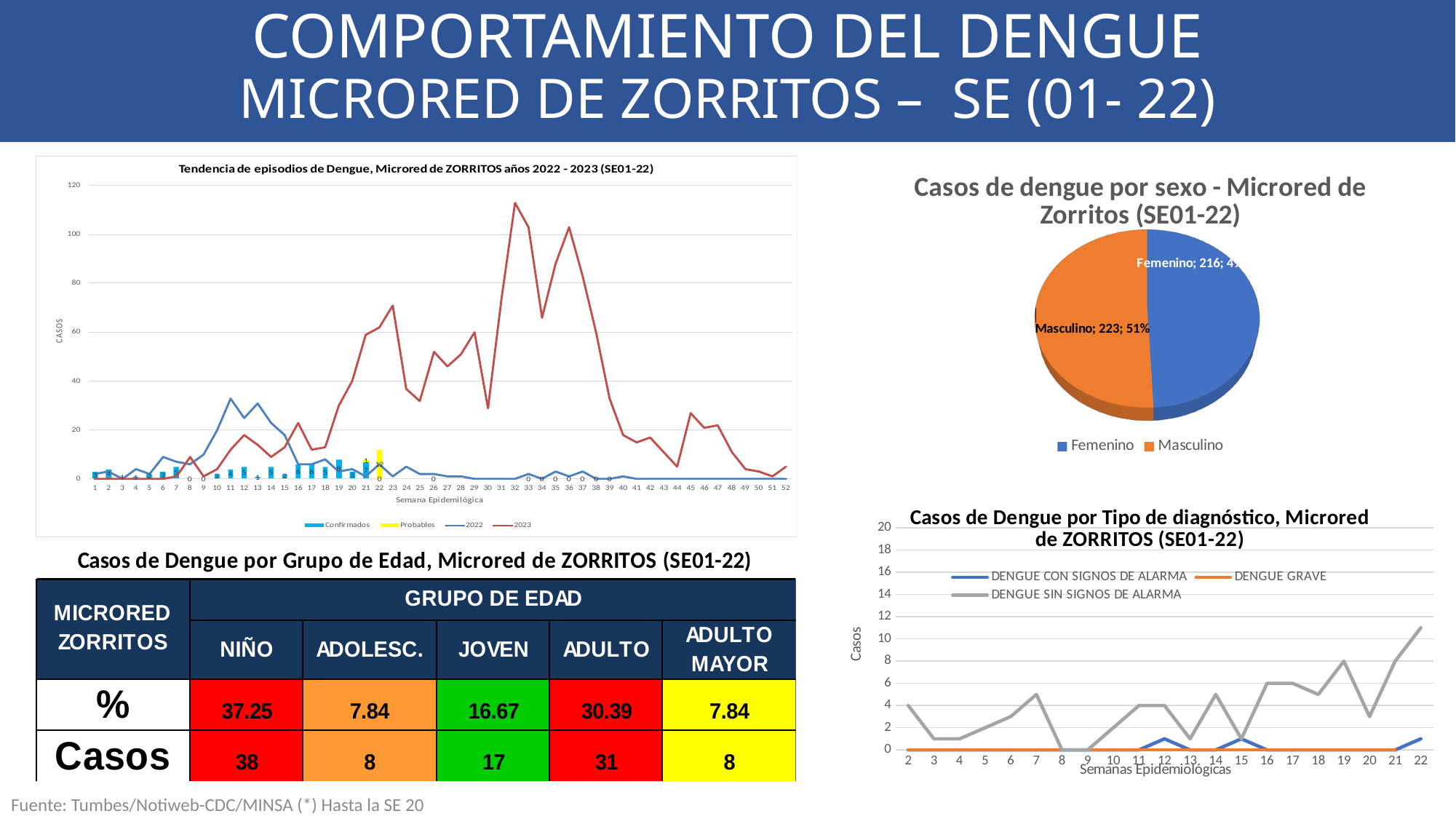
In the chart 'Tendencia de episodios de Dengue', is the 2023 value at week 32 greater or less than 100? greater In the pie chart 'Casos de dengue por sexo', how many cases are Femenino? 216 In the pie chart 'Casos de dengue por sexo', what share of cases is Masculino? 51% What kind of chart is 'Casos de dengue por sexo - Microred de Zorritos (SE01-22)'? pie chart In the chart 'Casos de Dengue por Tipo de diagnóstico', is the DENGUE SIN SIGNOS DE ALARMA value at week 22 greater or less than 8? greater In the chart 'Tendencia de episodios de Dengue', at which epidemiological week does the 2023 line reach its highest value? 32 How many series does the legend of the chart 'Tendencia de episodios de Dengue, Microred de ZORRITOS años 2022 - 2023' list? 4 How many series does the legend of the chart 'Casos de Dengue por Tipo de diagnóstico' list? 3 In the pie chart 'Casos de dengue por sexo', how many cases are Masculino? 223 In the pie chart 'Casos de dengue por sexo', what is the difference between the Masculino and Femenino case counts? 7 In the chart 'Casos de Dengue por Tipo de diagnóstico', which series has the highest values across the weeks? DENGUE SIN SIGNOS DE ALARMA In the pie chart 'Casos de dengue por sexo', which sex has more cases, Femenino or Masculino? Masculino